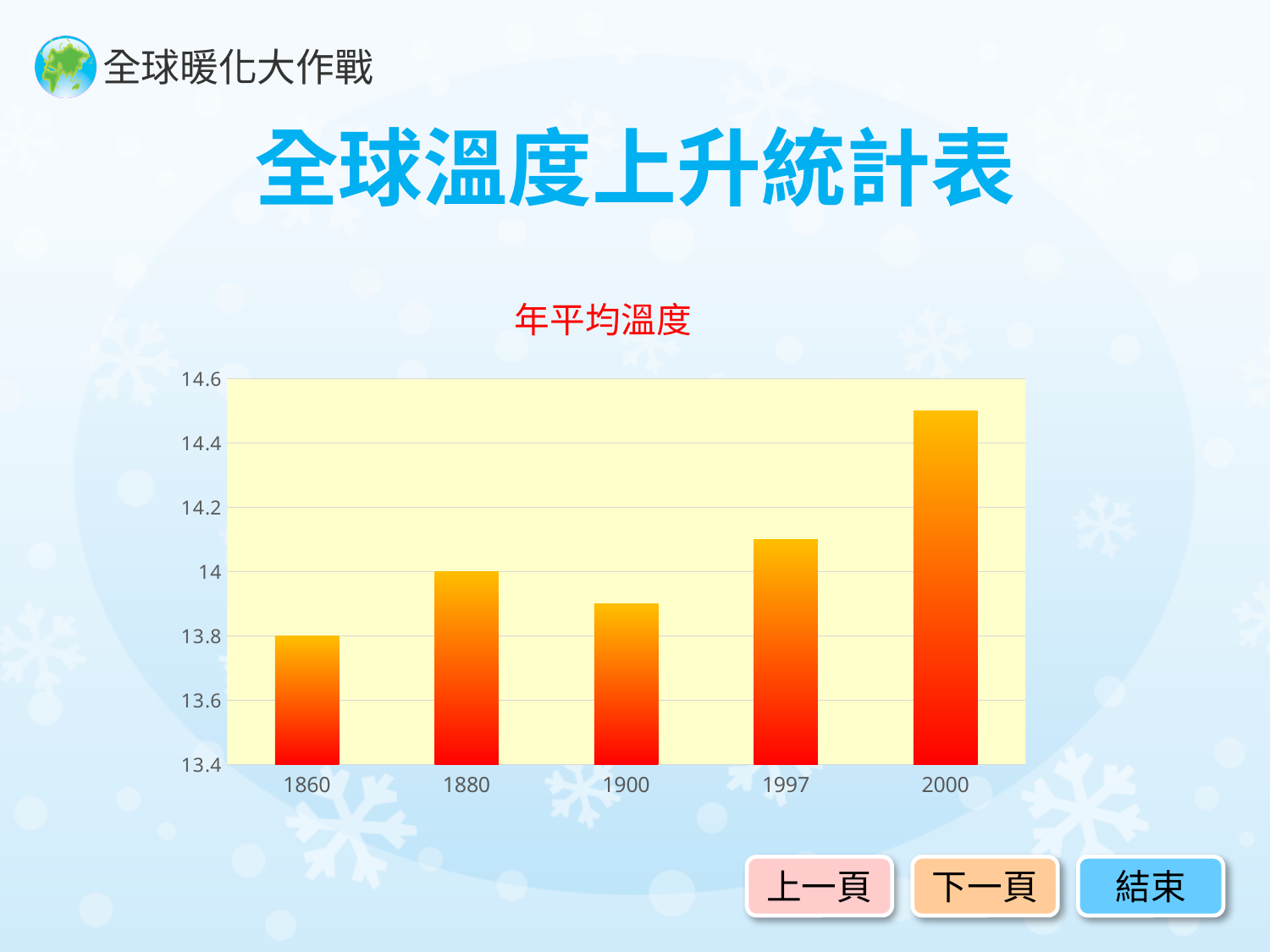
What is the value for 1860? 13.8 Is the value for 1900 greater or less than 14? less Is the value for 1997 greater or less than 14? greater Which year has the lowest value? 1860 Which is larger, the value for 1880 or the value for 1900? 1880 What is the difference between the values for 1880 and 1860? 0.2 Is the value for 2000 greater or less than 14.4? greater Which year has the highest value? 2000 What kind of chart is this? bar chart What is the value for 1880? 14 How many years are shown on the x axis? 5 Which is larger, the value for 1997 or the value for 2000? 2000